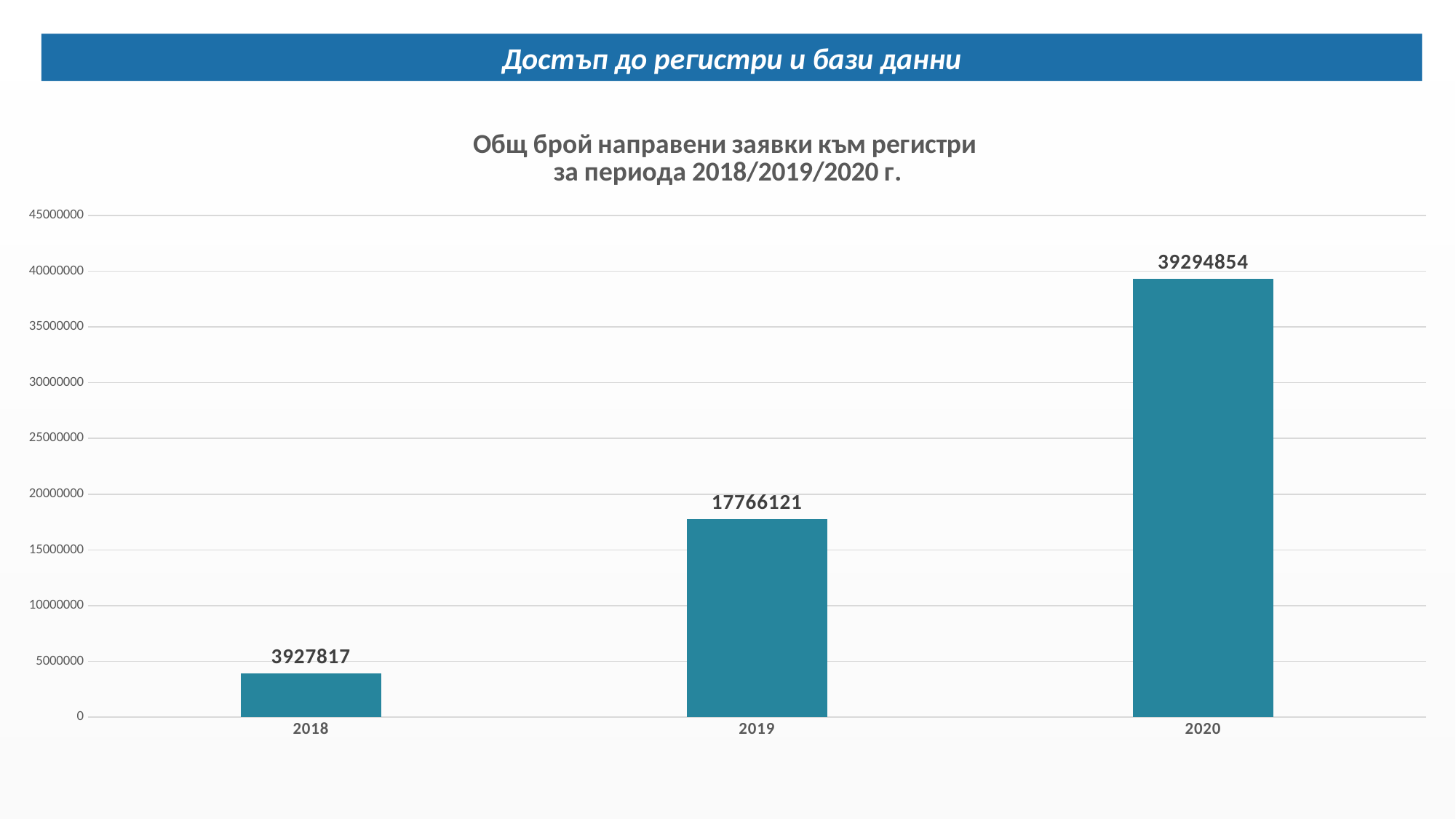
Which year has the lowest value? 2018 Is the value for 2020 greater or less than 35000000? greater What is the value for 2020? 39294854 Which year has the highest value? 2020 What kind of chart is shown on the slide? bar chart What is the value for 2019? 17766121 What is the difference between the values for 2019 and 2018? 13838304 What is the difference between the values for 2020 and 2019? 21528733 What is the value for 2018? 3927817 Which is larger, the value for 2019 or the value for 2018? 2019 Do the values rise or fall from 2018 to 2020? rise How many years are shown on the x axis? 3